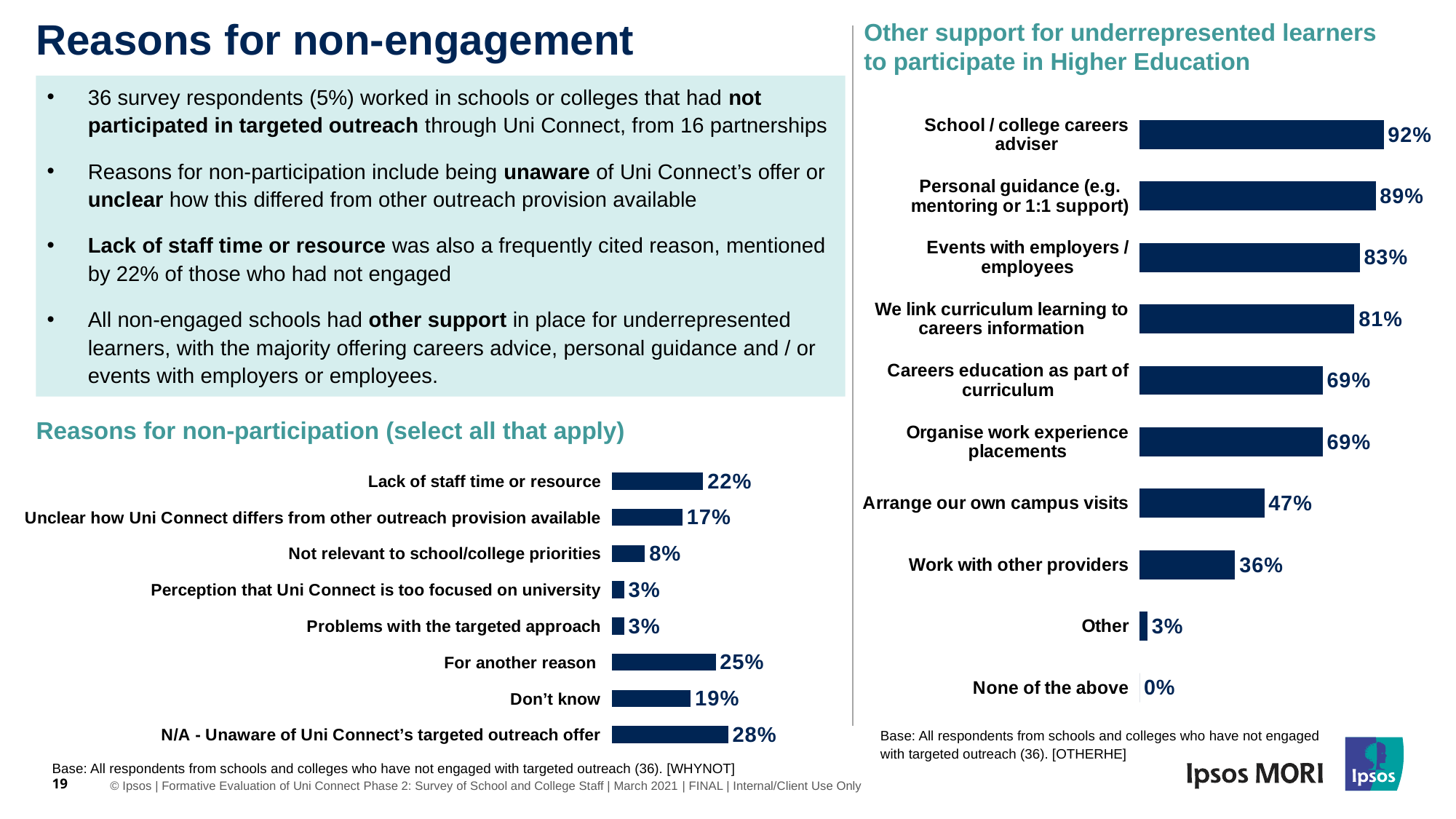
In the 'Other support for underrepresented learners to participate in Higher Education' chart, which category has the highest value? School / college careers adviser In the 'Reasons for non-participation (select all that apply)' chart, which category has the highest value? N/A - Unaware of Uni Connect's targeted outreach offer In the 'Other support for underrepresented learners to participate in Higher Education' chart, how many categories are shown? 10 What type of chart is the 'Other support for underrepresented learners to participate in Higher Education' chart? Bar chart In the 'Other support for underrepresented learners to participate in Higher Education' chart, what is the difference between 'School / college careers adviser' and 'Personal guidance (e.g. mentoring or 1:1 support)'? 3% In the 'Other support for underrepresented learners to participate in Higher Education' chart, which category has the lowest value? None of the above In the 'Other support for underrepresented learners to participate in Higher Education' chart, what is the value for 'Arrange our own campus visits'? 47% In the 'Reasons for non-participation (select all that apply)' chart, which is larger: 'Unclear how Uni Connect differs from other outreach provision available' or 'Not relevant to school/college priorities'? Unclear how Uni Connect differs from other outreach provision available In the 'Reasons for non-participation (select all that apply)' chart, what is the value for 'Lack of staff time or resource'? 22% In the 'Other support for underrepresented learners to participate in Higher Education' chart, what is the value for 'Work with other providers'? 36% In the 'Reasons for non-participation (select all that apply)' chart, what is the difference between 'For another reason' and 'Don't know'? 6% In the 'Reasons for non-participation (select all that apply)' chart, how many categories are shown? 8